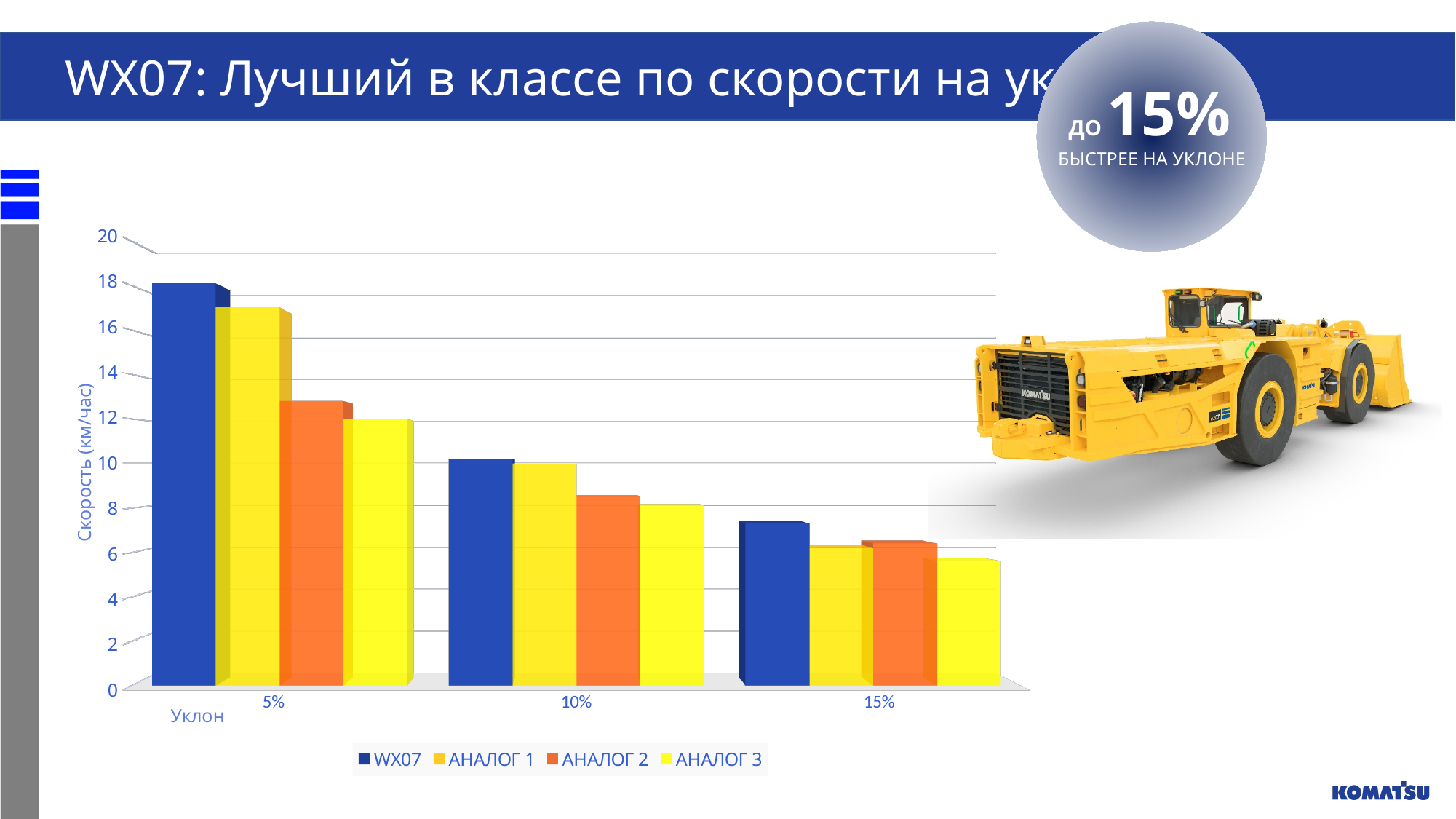
Do the WX07 values rise or fall as the slope increases from 5% to 15%? Fall Is the value for WX07 at the 5% slope greater or less than 16? greater How many slope categories are shown on the x axis? 3 How many series does the chart legend list? 4 Which series has the highest value at the 5% slope? WX07 Which is larger: the WX07 value at the 5% slope or the WX07 value at the 15% slope? 5% slope Is the value for АНАЛОГ 3 at the 5% slope greater or less than 14? less Is the value for АНАЛОГ 2 at the 10% slope greater or less than 10? less What is the title of the vertical axis? Скорость (км/час) Which series has the lowest value at the 15% slope? АНАЛОГ 3 What kind of chart is shown on the slide? Bar chart